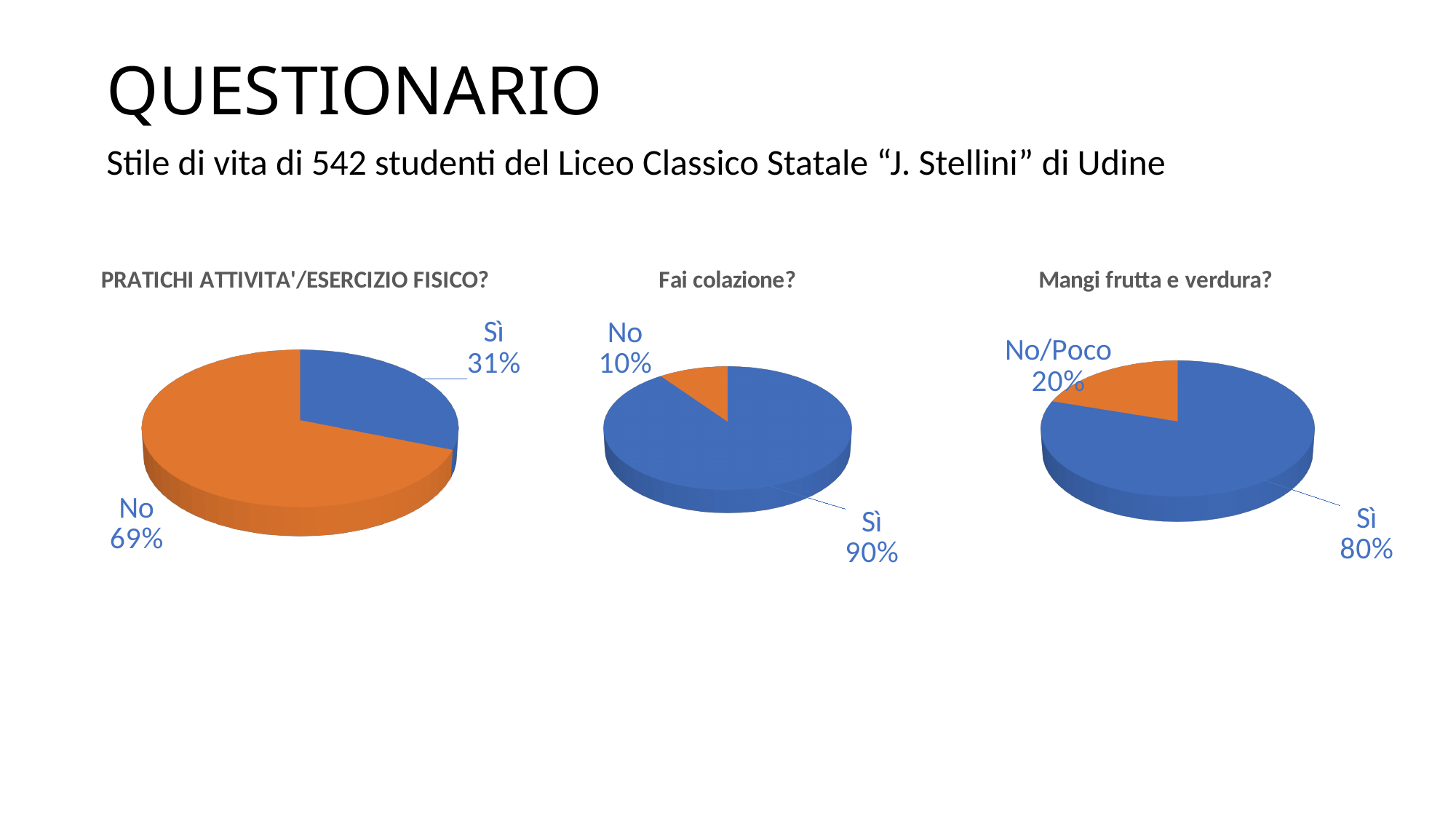
What kind of chart is the chart titled "Mangi frutta e verdura?"? Pie chart How many categories does the chart titled "PRATICHI ATTIVITA'/ESERCIZIO FISICO?" have? 2 In the chart titled "Fai colazione?", which category is the smallest? No In the chart titled "Fai colazione?", what share of the pie is "Sì"? 90% In the chart titled "Mangi frutta e verdura?", what is the value for "Sì"? 80% In the chart titled "Fai colazione?", what is the value for "No"? 10% In the chart titled "Fai colazione?", which is larger, "Sì" or "No"? Sì In the chart titled "Mangi frutta e verdura?", what is the value for "No/Poco"? 20% In the chart titled "PRATICHI ATTIVITA'/ESERCIZIO FISICO?", which category is the largest? No In the chart titled "Mangi frutta e verdura?", what is the difference between "Sì" and "No/Poco"? 60% In the chart titled "PRATICHI ATTIVITA'/ESERCIZIO FISICO?", what share of the pie is "No"? 69% In the chart titled "PRATICHI ATTIVITA'/ESERCIZIO FISICO?", what is the value for "Sì"? 31%